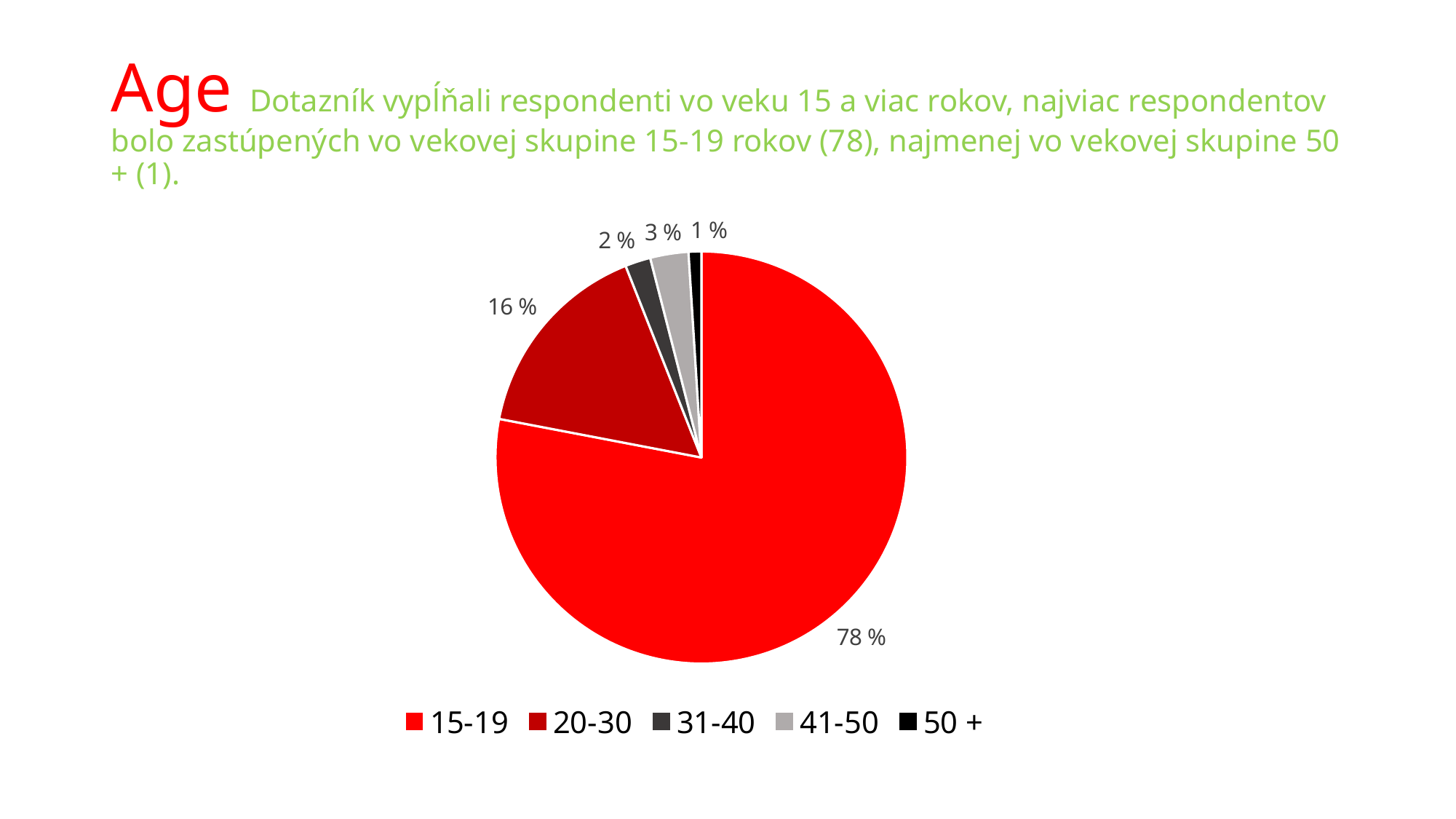
What is the value shown for the 31-40 age group? 2 % What is the difference in percentage points between the 15-19 and 20-30 slices? 62 How many age groups are shown in the pie chart? 5 What share of the pie does the 15-19 age group have? 78 % What share of the pie does the 20-30 age group have? 16 % Which age group has the smallest slice of the pie? 50 + Which age group has the largest slice of the pie? 15-19 What kind of chart is shown on the slide? pie chart What is the value shown for the 41-50 age group? 3 % What colour is the slice for the 20-30 age group? dark red Which slice is larger, 41-50 or 31-40? 41-50 What is the value shown for the 50 + age group? 1 %